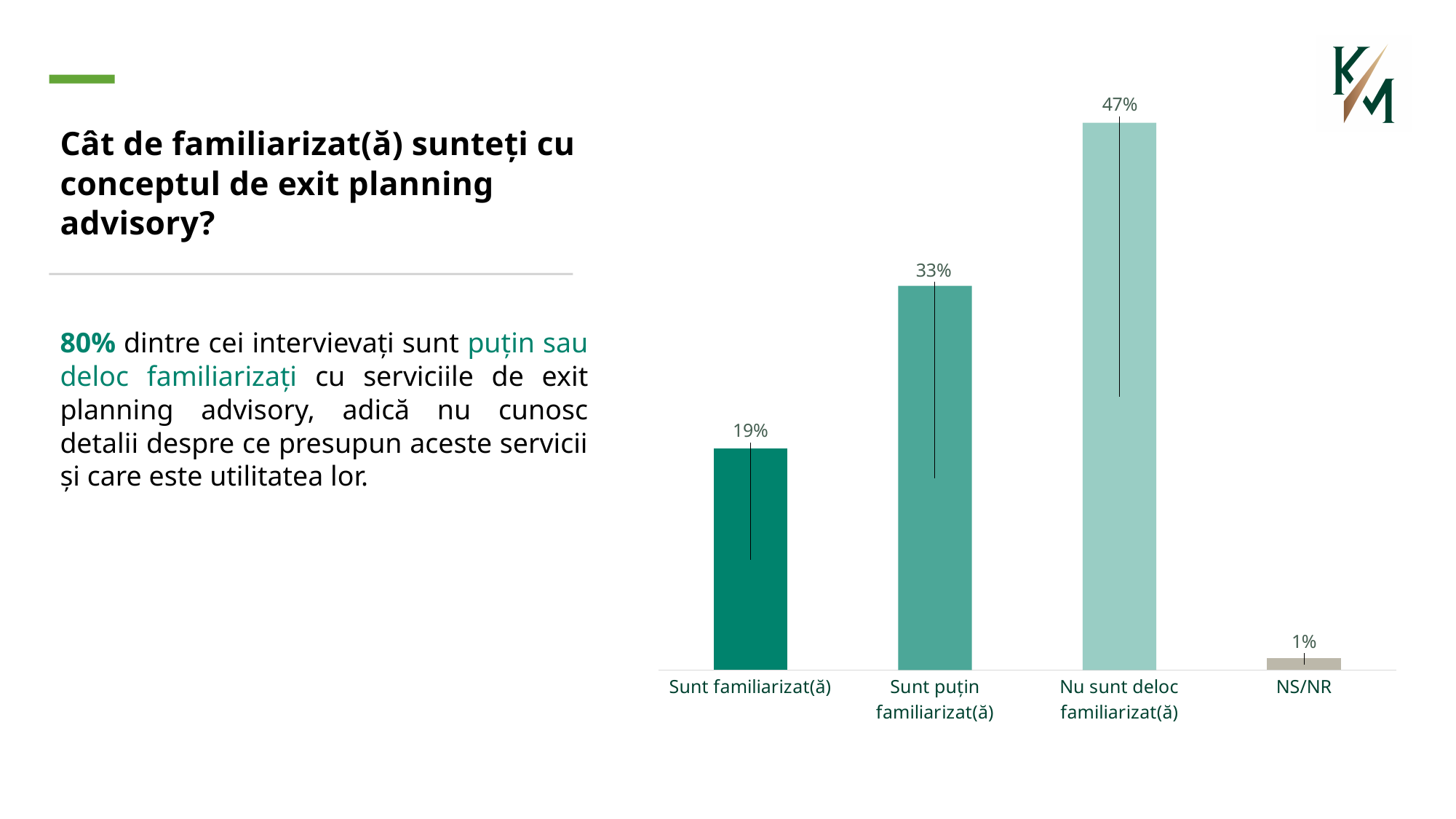
Which is larger, the value for "Sunt puțin familiarizat(ă)" or the value for "Sunt familiarizat(ă)"? Sunt puțin familiarizat(ă) What is the value for "Nu sunt deloc familiarizat(ă)"? 47% What is the combined value of "Sunt puțin familiarizat(ă)" and "Nu sunt deloc familiarizat(ă)"? 80% What is the value for "Sunt puțin familiarizat(ă)"? 33% How many categories are shown in the chart? 4 Which category has the highest value? Nu sunt deloc familiarizat(ă) What is the value for "Sunt familiarizat(ă)"? 19% What is the difference between the values for "Nu sunt deloc familiarizat(ă)" and "Sunt familiarizat(ă)"? 28% What is the difference between the values for "Sunt puțin familiarizat(ă)" and "Sunt familiarizat(ă)"? 14% Which category has the lowest value? NS/NR What kind of chart is shown on the slide? Bar chart What is the value for "NS/NR"? 1%